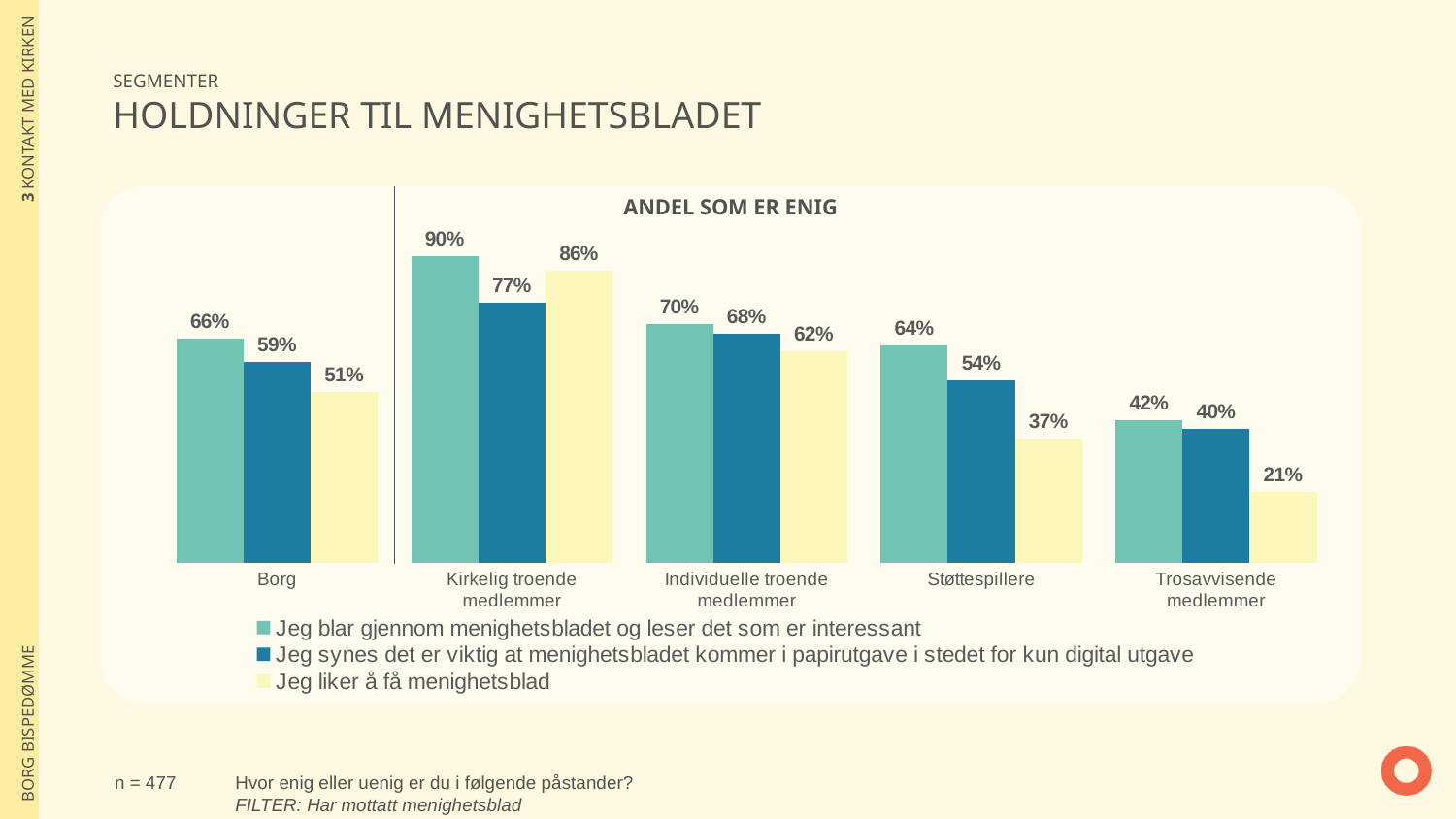
What is the title of the chart? ANDEL SOM ER ENIG Which category has the highest value for 'Jeg blar gjennom menighetsbladet og leser det som er interessant'? Kirkelig troende medlemmer Which category has the lowest value for 'Jeg liker å få menighetsblad'? Trosavvisende medlemmer How many series does the legend list? 3 What is the value for 'Jeg synes det er viktig at menighetsbladet kommer i papirutgave i stedet for kun digital utgave' among Støttespillere? 54% What is the value for 'Jeg blar gjennom menighetsbladet og leser det som er interessant' in the Borg category? 66% What is the sample size (n) stated on the slide? 477 How many categories are shown on the x axis? 5 Which is larger: the 'Jeg liker å få menighetsblad' value for Individuelle troende medlemmer or for Støttespillere? Individuelle troende medlemmer What kind of chart is shown on the slide? Bar chart What is the difference between the 'Jeg liker å få menighetsblad' values for Kirkelig troende medlemmer and Trosavvisende medlemmer? 65 percentage points What is the value for 'Jeg liker å få menighetsblad' among Kirkelig troende medlemmer? 86%